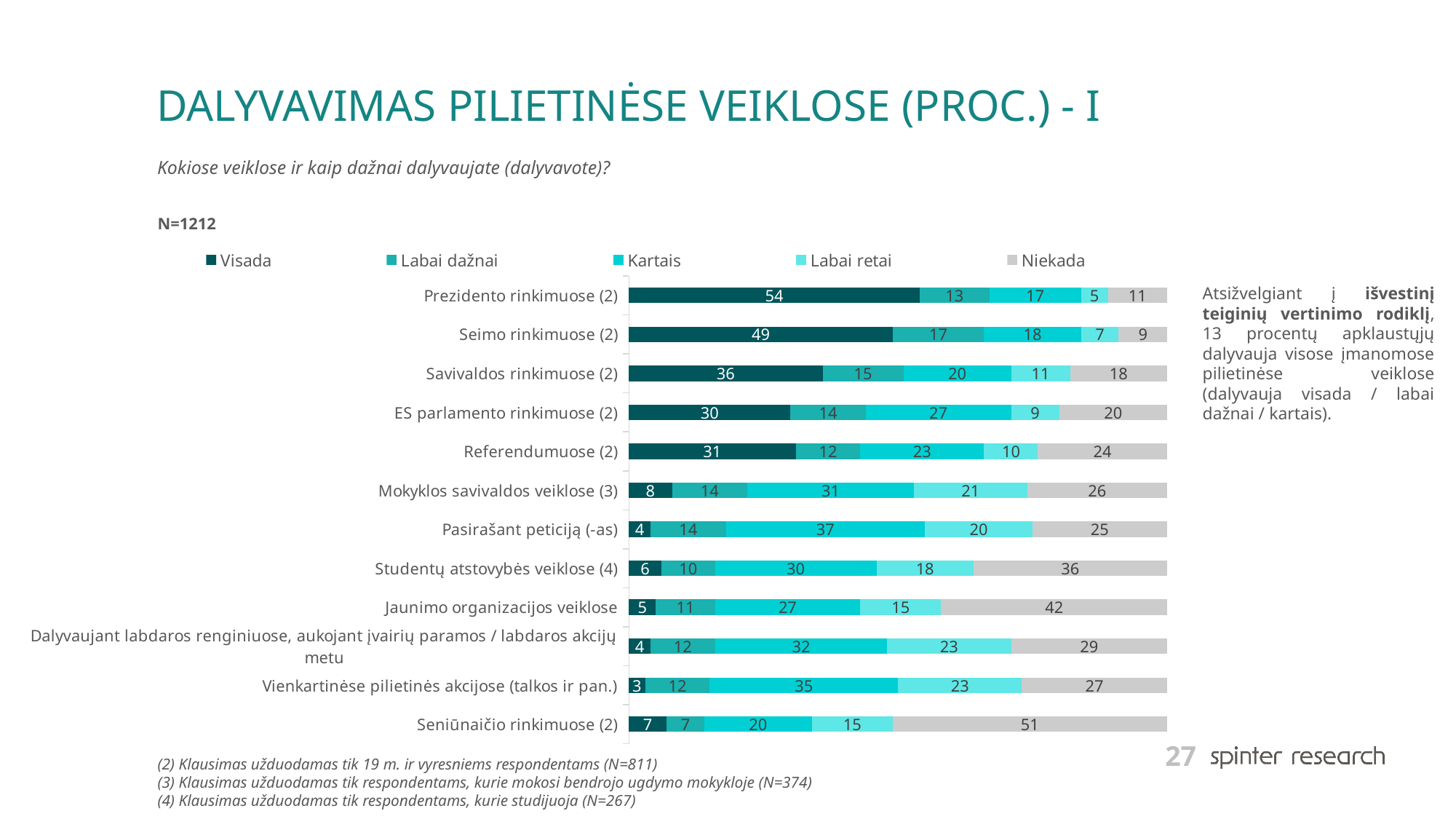
What is the difference between the 'Visada' values for 'Prezidento rinkimuose (2)' and 'Seimo rinkimuose (2)'? 5 Which has a larger 'Niekada' value: 'Jaunimo organizacijos veiklose' or 'Studentų atstovybės veiklose (4)'? Jaunimo organizacijos veiklose What sample size (N) is stated on the slide? N=1212 What is the 'Visada' value for 'Prezidento rinkimuose (2)'? 54 Which category has the highest 'Visada' value? Prezidento rinkimuose (2) What type of chart is shown on the slide? stacked bar chart How many categories are plotted on the chart? 12 Which category has the lowest 'Visada' value? Vienkartinėse pilietinės akcijose (talkos ir pan.) What is the 'Kartais' value for 'Pasirašant peticiją (-as)'? 37 What is the total of the stacked bar for 'Referendumuose (2)'? 100 What is the 'Niekada' value for 'Seniūnaičio rinkimuose (2)'? 51 How many series does the legend list? 5